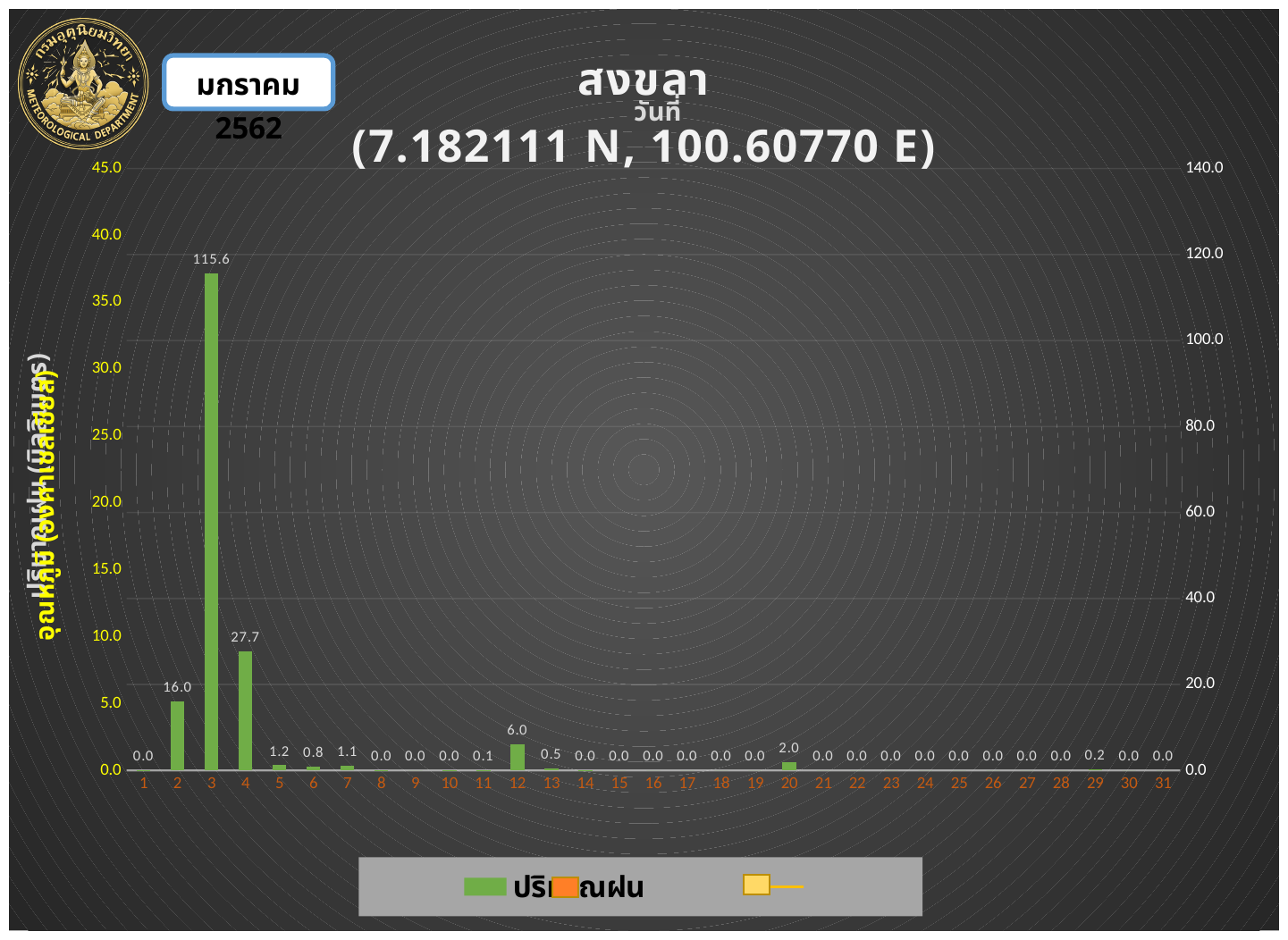
What is the rainfall value shown for day 3? 115.6 What is the difference between the rainfall values for day 3 and day 4? 87.9 What colour are the rainfall (ปริมาณฝน) bars? green What kind of chart is shown on the slide? bar chart What is the rainfall value shown for day 12? 6.0 How many days are shown on the x axis? 31 Which day has the highest rainfall value? 3 What is the rainfall value shown for day 20? 2.0 What is the rainfall value shown for day 4? 27.7 What is the rainfall value shown for day 29? 0.2 Which has the larger rainfall value, day 2 or day 12? day 2 What is the rainfall value shown for day 2? 16.0